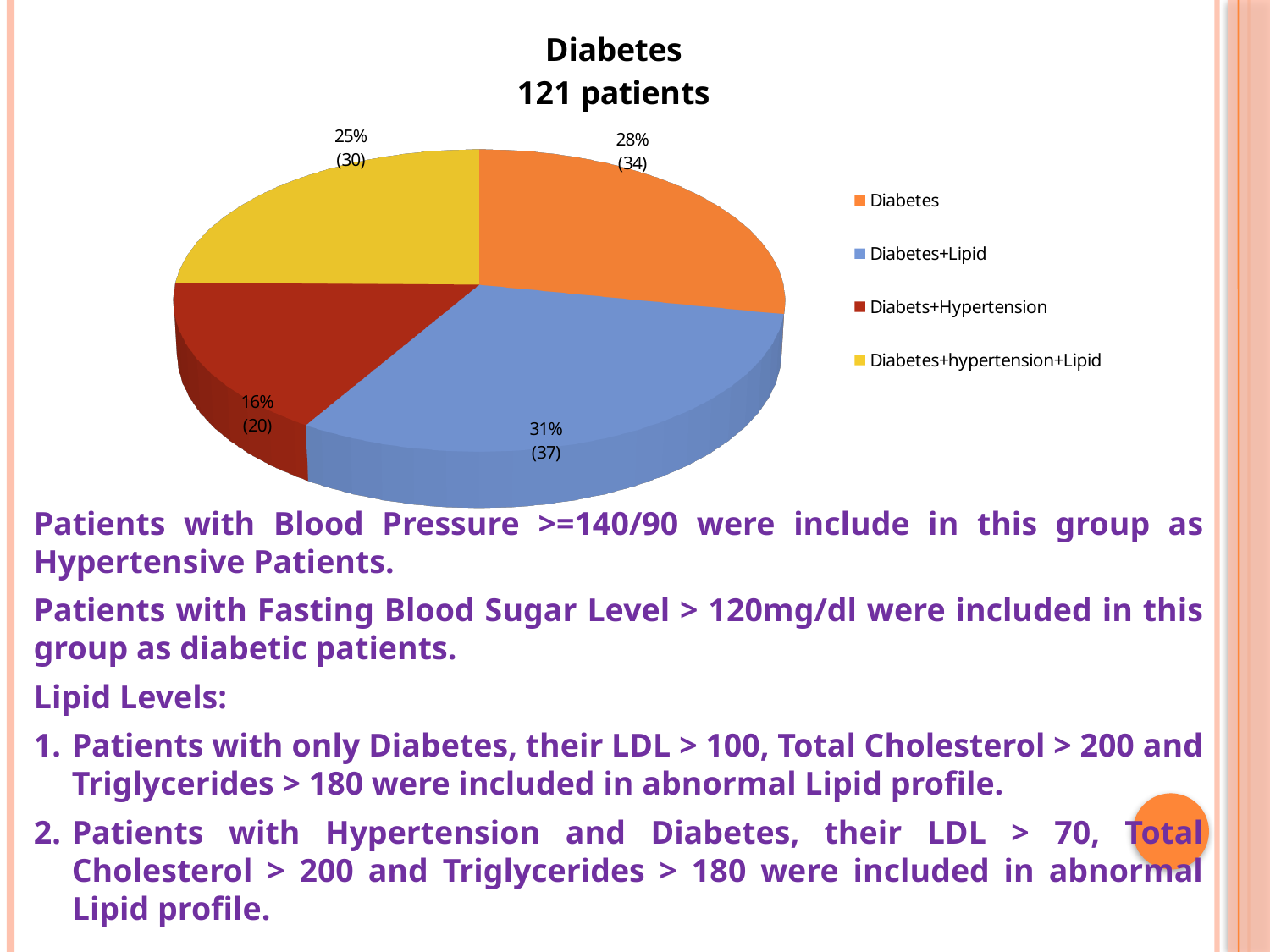
Which category has more patients, Diabetes or Diabetes+hypertension+Lipid? Diabetes What percentage of the pie does the Diabetes slice represent? 28% How many patients are in the Diabetes+Lipid category? 37 How many patients are in the Diabetes+hypertension+Lipid category? 30 How many more patients are in the Diabetes+Lipid category than in the Diabets+Hypertension category? 17 What kind of chart is shown on the slide? Pie chart What is the title of the pie chart? Diabetes 121 patients What percentage of the pie does the Diabets+Hypertension slice represent? 16% What is the total number of patients across all four slices of the pie chart? 121 Which category has the largest share of the pie? Diabetes+Lipid Which category has the smallest share of the pie? Diabets+Hypertension How many slices does the pie chart have? 4